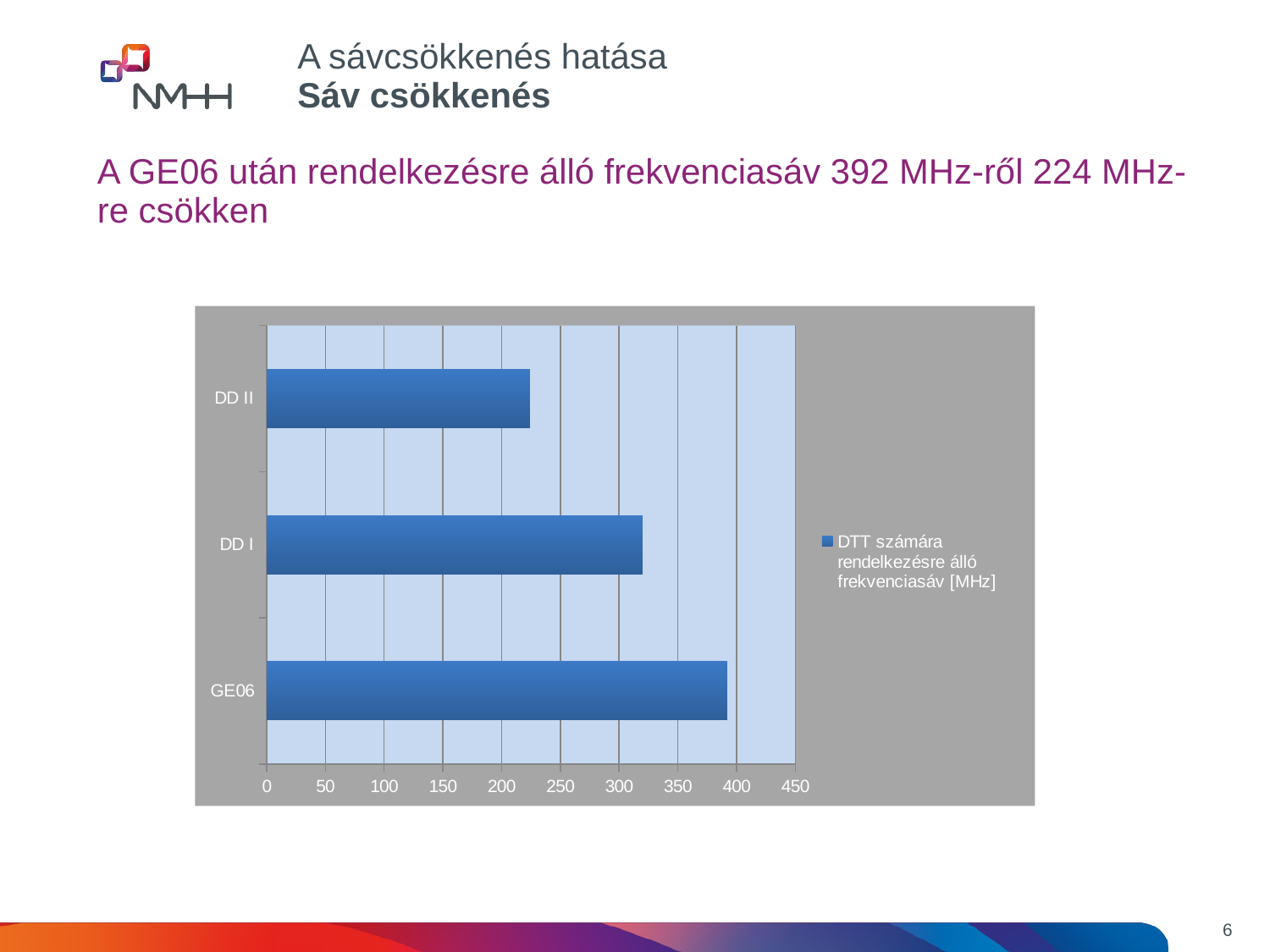
Is the value for GE06 greater or less than 350? greater Is the value for DD II greater or less than 250? less How many categories are plotted in the chart? 3 Which category has the highest value in the chart? GE06 Is the value for DD II greater or less than 200? greater Which has the larger value, DD I or DD II? DD I How many series does the chart legend list? 1 What is the series name shown in the chart legend? DTT számára rendelkezésre álló frekvenciasáv [MHz] What is the highest tick value shown on the horizontal axis of the chart? 450 What kind of chart is shown on the slide? bar chart Which category has the lowest value in the chart? DD II